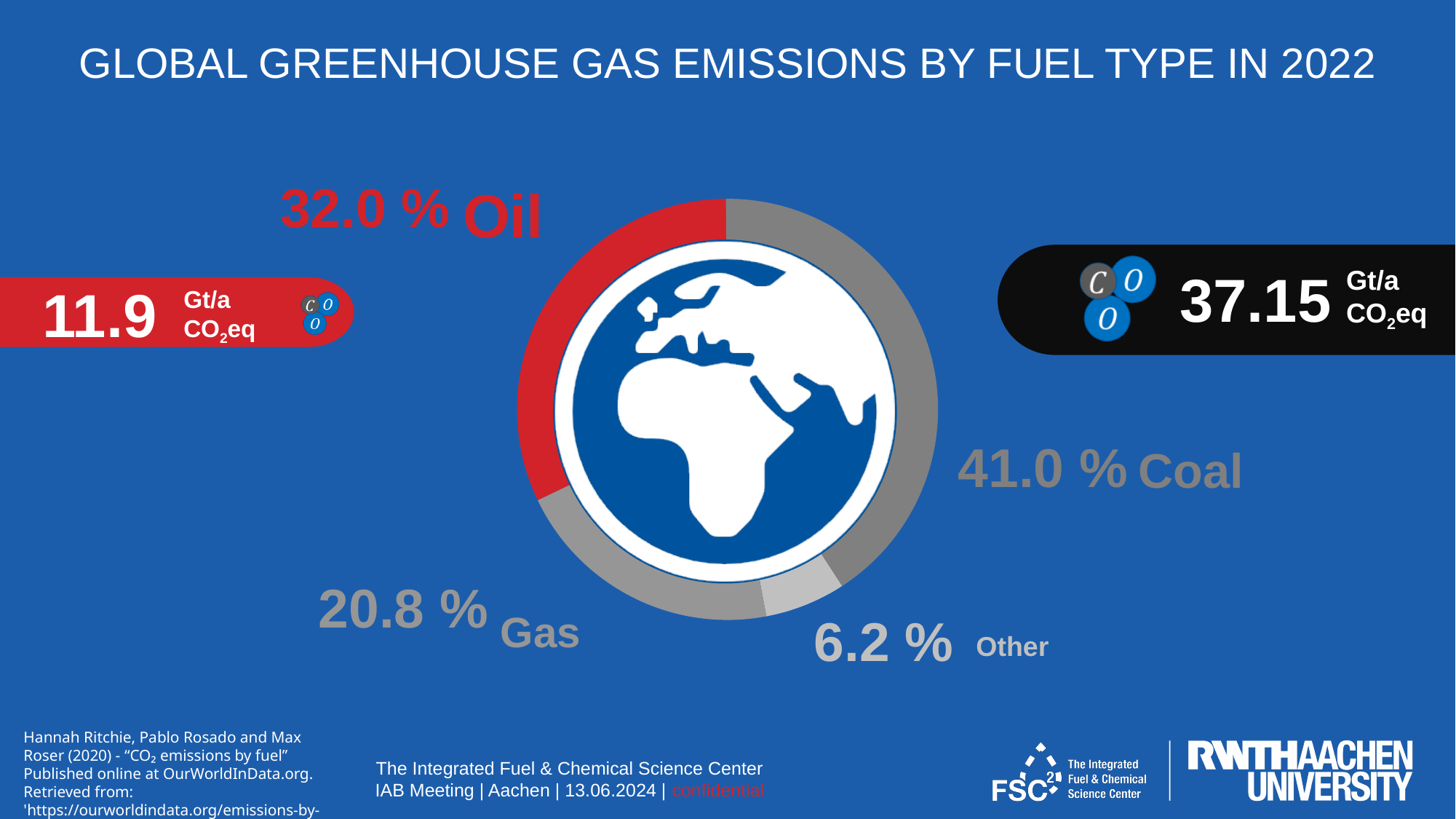
What total annual emissions figure is shown in the black callout on the right? 37.15 Gt/a CO2eq What colour is the Oil slice of the chart? Red What percentage is shown for Gas? 20.8 % What share of the donut chart is labelled Oil? 32.0 % How many fuel-type categories are shown in the chart? 4 What share of global greenhouse gas emissions by fuel type in 2022 does Coal account for? 41.0 % Which fuel type has the largest share of emissions in the chart? Coal Which fuel type has the smallest share of emissions in the chart? Other What kind of chart is used to show the emissions by fuel type? Donut (pie) chart How many percentage points larger is the Coal share than the Oil share? 9.0 % Which has a larger share, Gas or Oil? Oil What percentage is shown for Other? 6.2 %